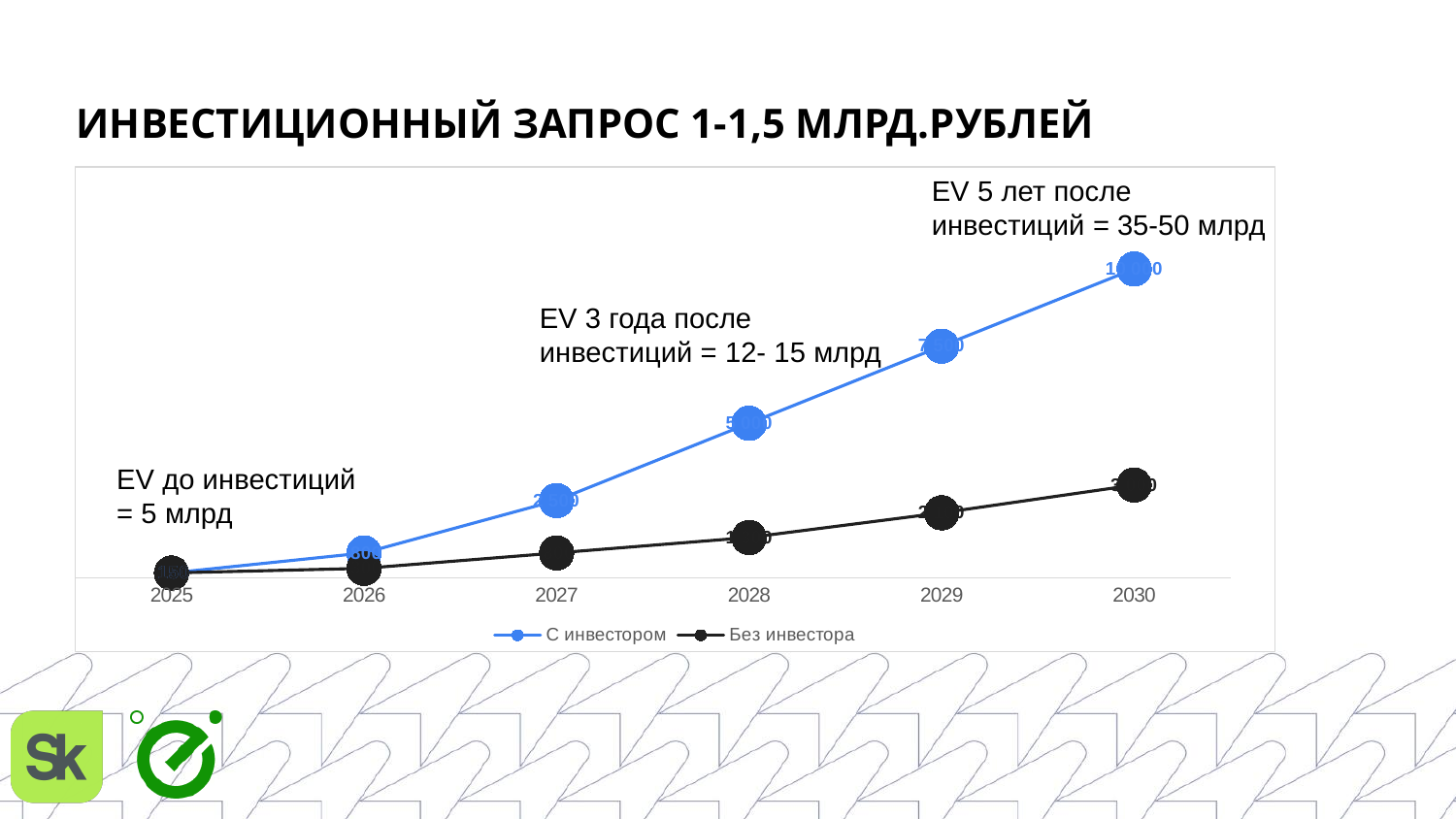
In which year does the 'С инвестором' series reach its highest value? 2030 Which series is drawn in blue on the chart? С инвестором What are the two series names listed in the chart legend? С инвестором, Без инвестора How many series does the chart legend list? 2 Do the values of the 'Без инвестора' series rise or fall from 2025 to 2030? Rise In 2028, which series has the higher value, 'С инвестором' or 'Без инвестора'? С инвестором In 2030, which series has the higher value, 'С инвестором' or 'Без инвестора'? С инвестором What kind of chart is shown on the slide? Line chart How many years are shown along the x axis of the chart? 6 In which year does the 'С инвестором' series have its lowest value? 2025 In which year does the 'Без инвестора' series reach its highest value? 2030 Do the values of the 'С инвестором' series rise or fall from 2025 to 2030? Rise